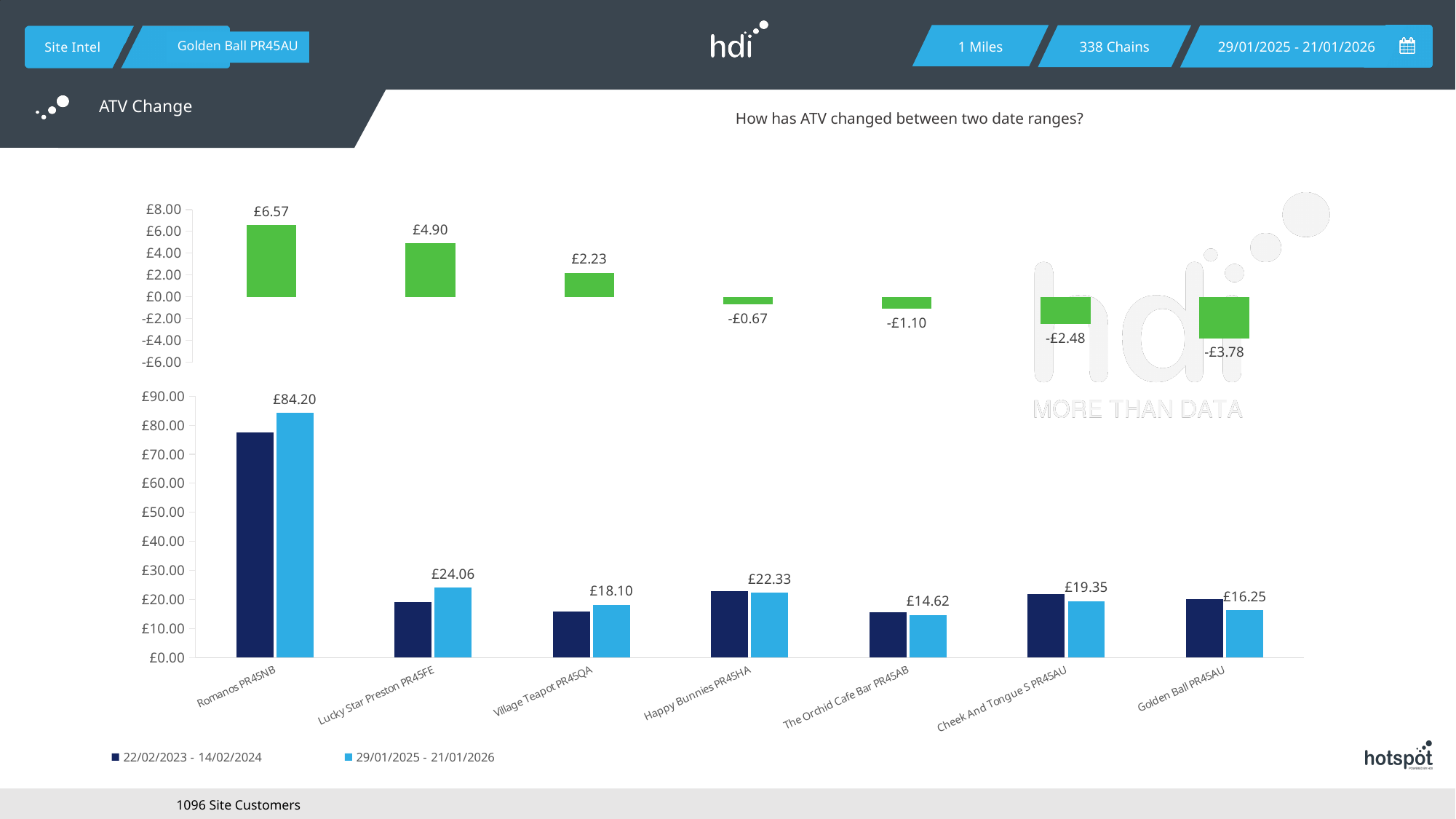
In the top chart (ATV change), what is the value for Golden Ball PR45AU? -£3.78 In the bottom chart, which is larger in the 29/01/2025 - 21/01/2026 series: Lucky Star Preston PR45FE or Village Teapot PR45QA? Lucky Star Preston PR45FE In the top chart (ATV change), what is the difference between the values for Romanos PR45NB and Lucky Star Preston PR45FE? £1.67 In the bottom chart, what is the value for Happy Bunnies PR45HA in the 29/01/2025 - 21/01/2026 series? £22.33 In the bottom chart, how many series does the legend list? 2 In the bottom chart, which site has the highest value in the 29/01/2025 - 21/01/2026 series? Romanos PR45NB In the bottom chart, is the value for Romanos PR45NB in the 22/02/2023 - 14/02/2024 series greater or less than £70.00? greater In the top chart (ATV change), what is the value for Romanos PR45NB? £6.57 In the top chart (ATV change), how many sites are plotted? 7 In the top chart (ATV change), which site has the highest value? Romanos PR45NB In the bottom chart, what is the difference between the 29/01/2025 - 21/01/2026 values for Happy Bunnies PR45HA and The Orchid Cafe Bar PR45AB? £7.71 In the top chart (ATV change), which site has the lowest value? Golden Ball PR45AU